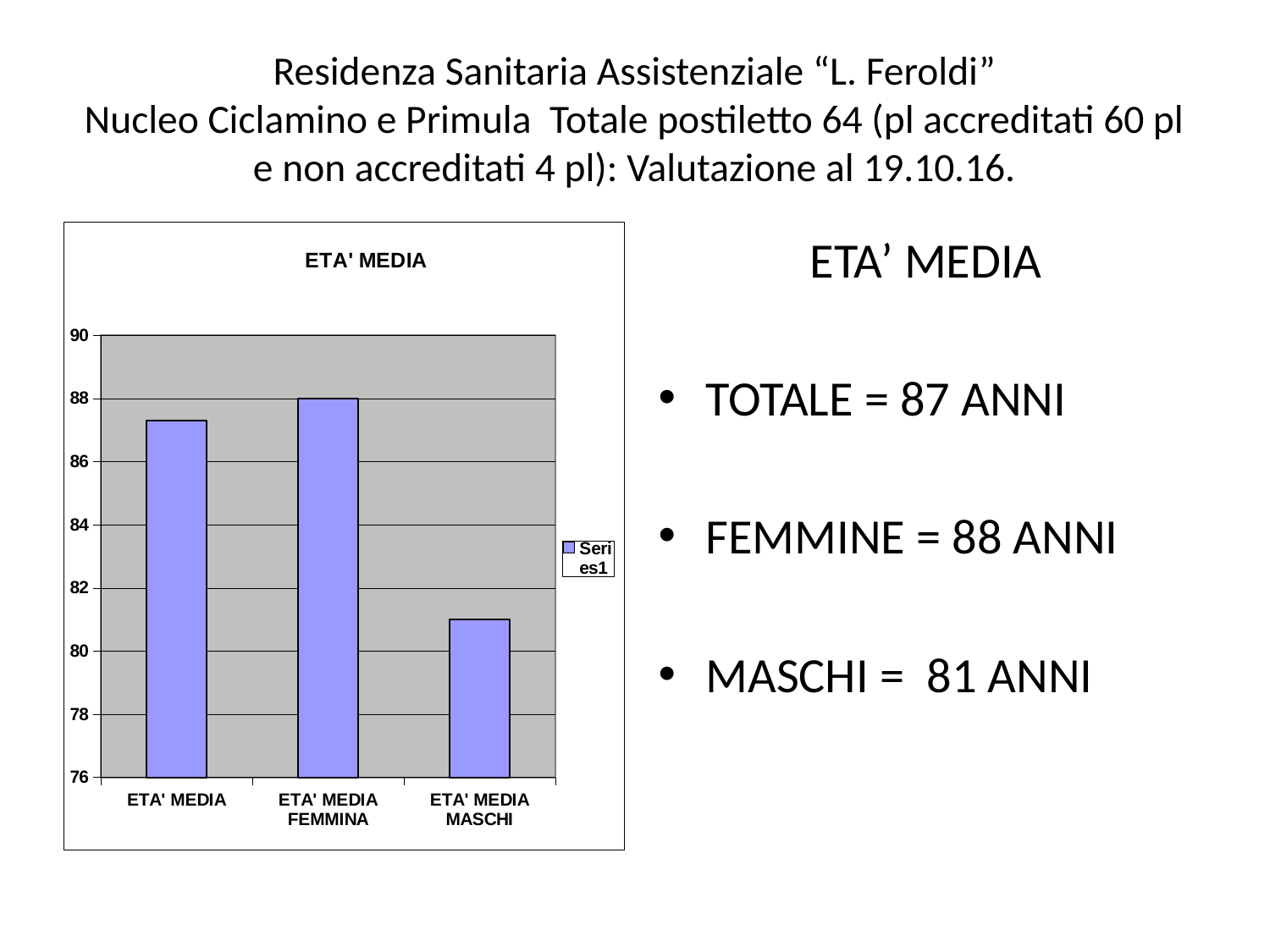
What is the value of the ETA' MEDIA FEMMINA bar? 88 What kind of chart is shown on the slide? bar chart What is the name of the series shown in the chart legend? Series1 What is the title of the chart? ETA' MEDIA Is the value for ETA' MEDIA (the first bar) greater or less than 86? greater Which category has the lowest bar in the chart? ETA' MEDIA MASCHI Is the value for ETA' MEDIA MASCHI greater or less than 82? less Which is larger, the ETA' MEDIA bar or the ETA' MEDIA MASCHI bar? ETA' MEDIA Is the value for ETA' MEDIA MASCHI greater or less than 80? greater How many series does the chart legend list? 1 How many bars (categories) does the chart show? 3 Which category has the highest bar in the chart? ETA' MEDIA FEMMINA